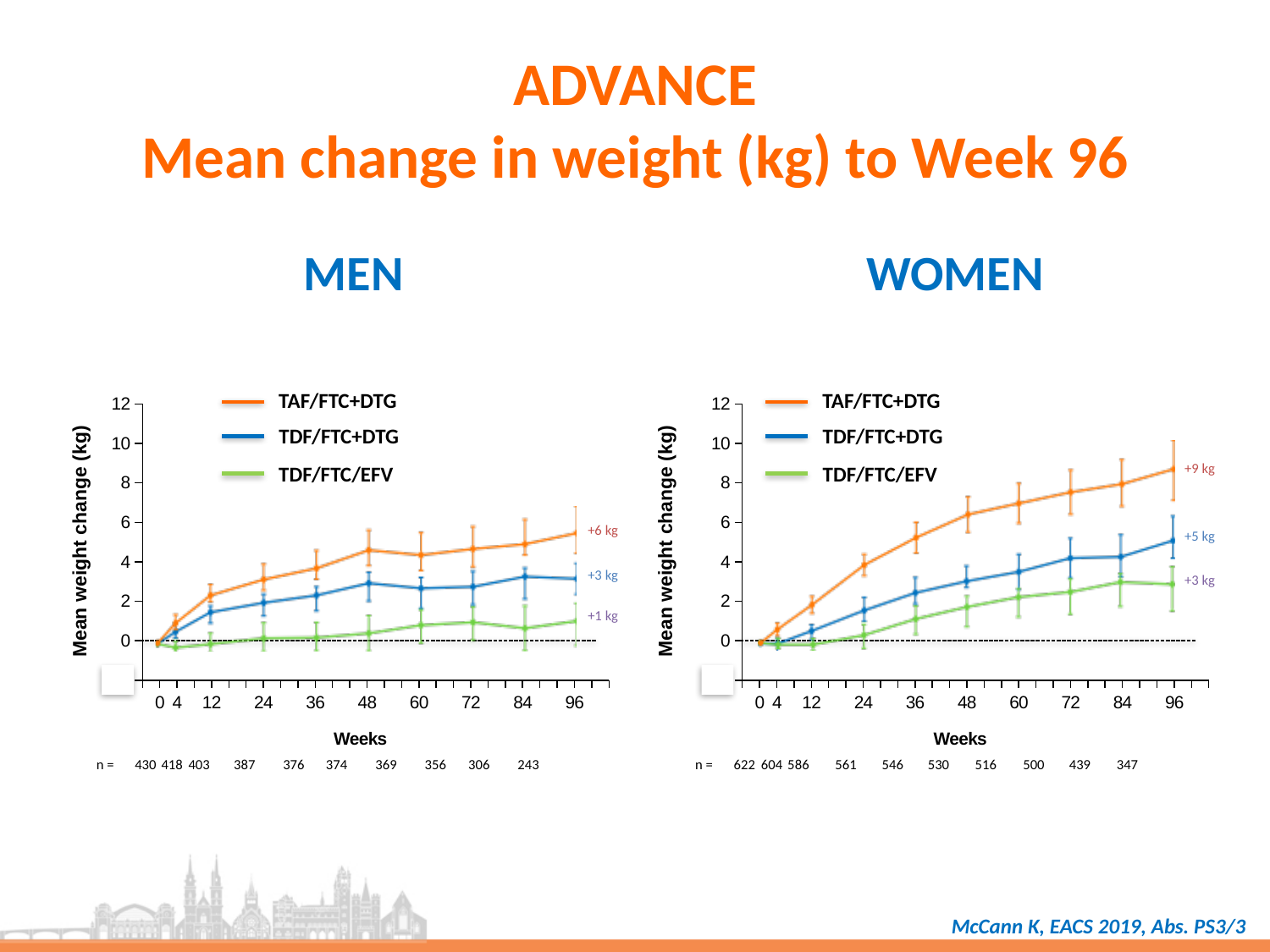
How many week time points are marked on the x axis of the WOMEN chart? 10 In the WOMEN chart, what is the difference between the Week 96 labelled values for TAF/FTC+DTG and TDF/FTC/EFV? 6 kg In the WOMEN chart, what is the mean weight change at Week 96 for TDF/FTC/EFV, as labelled at the end of the line? +3 kg In the WOMEN chart, what is the mean weight change at Week 96 for TDF/FTC+DTG, as labelled at the end of the line? +5 kg In the WOMEN chart, which regimen shows the lowest mean weight change at Week 96? TDF/FTC/EFV Is the Week 96 mean weight change for TAF/FTC+DTG larger in the MEN chart or the WOMEN chart? WOMEN How many series does the legend list in the MEN chart? 3 In the MEN chart, which regimen shows the highest mean weight change at Week 96? TAF/FTC+DTG In the WOMEN chart, does the TAF/FTC+DTG line rise or fall from Week 0 to Week 96? Rise What kind of chart is used for the MEN panel? Line chart In the WOMEN chart, is the value for TAF/FTC+DTG at Week 48 greater or less than 4? greater In the MEN chart, what is the mean weight change at Week 96 for TAF/FTC+DTG, as labelled at the end of the line? +6 kg